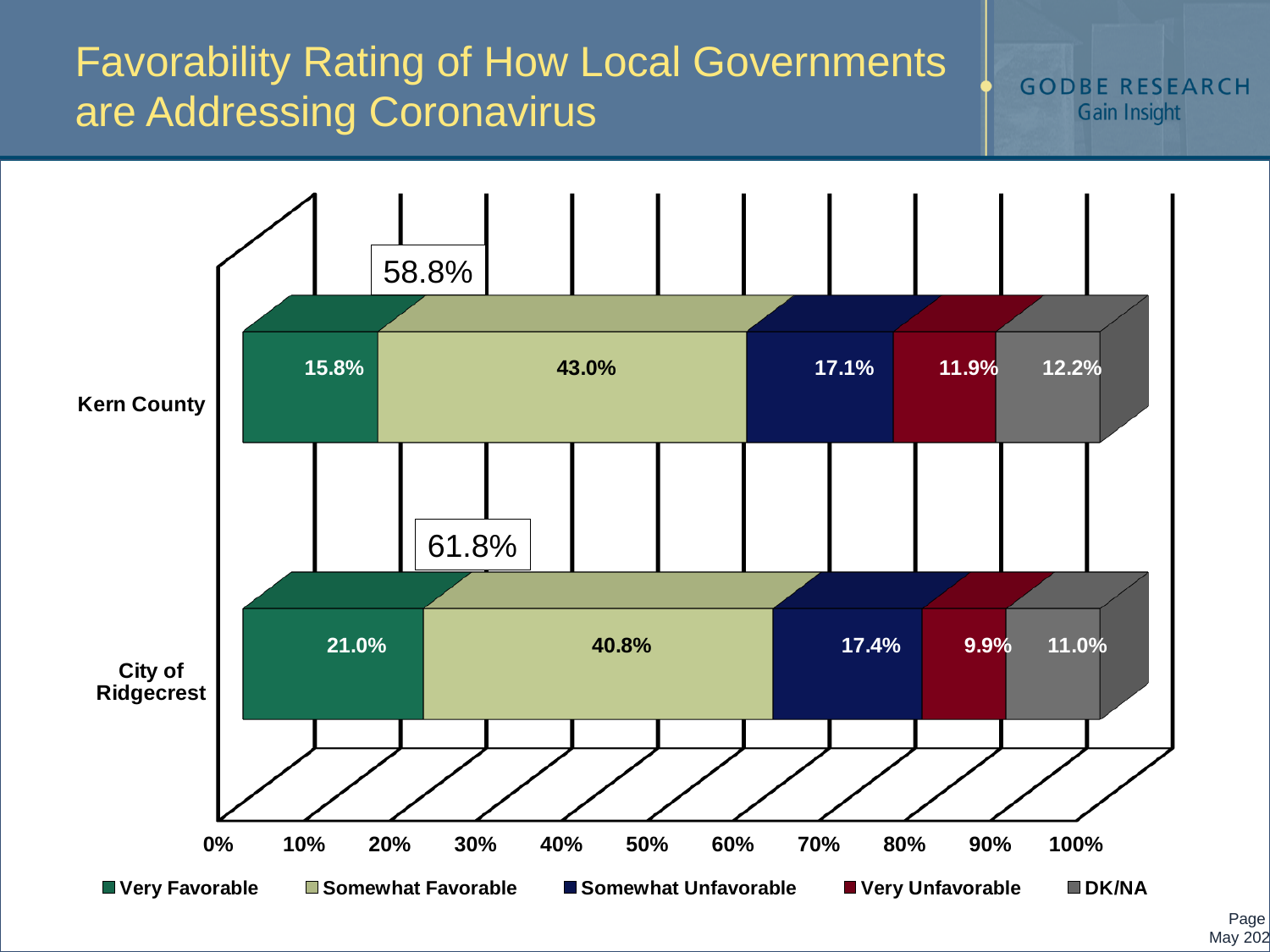
What kind of chart is shown on the slide? Stacked bar chart What is the combined favorable (Very Favorable plus Somewhat Favorable) value shown above the Kern County bar? 58.8% What is the Very Unfavorable value for City of Ridgecrest? 9.9% Which category has the larger Very Favorable value, Kern County or City of Ridgecrest? City of Ridgecrest What is the Very Favorable value for Kern County? 15.8% How many categories are shown on the chart? 2 What is the difference between the Somewhat Favorable values for Kern County and City of Ridgecrest? 2.2% How many series does the legend list? 5 What is the DK/NA value for Kern County? 12.2% Which series has the highest value for Kern County? Somewhat Favorable Which series has the lowest value for City of Ridgecrest? Very Unfavorable What is the Somewhat Favorable value for City of Ridgecrest? 40.8%